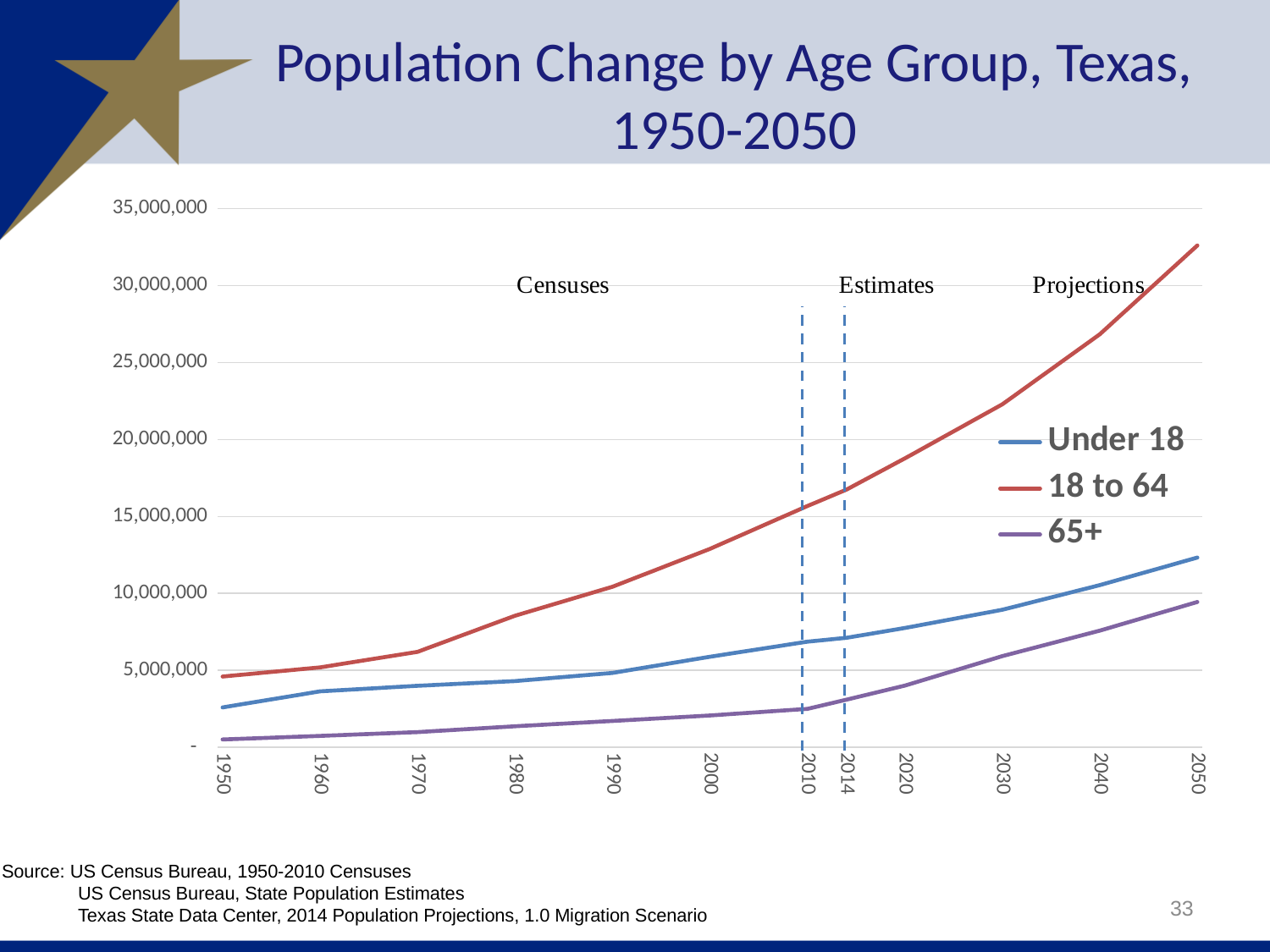
Which age group has the highest population in 2050? 18 to 64 Which age group has the lowest population in 1950? 65+ How many year labels are shown along the x axis? 12 Is the value for 65+ in 2050 greater or less than 10,000,000? less Is the value for Under 18 in 1950 greater or less than 5,000,000? less How many series does the legend list? 3 What kind of chart is shown on the slide? Line chart Does the 18 to 64 population rise or fall from 1950 to 2050? Rises Is the value for 18 to 64 in 2030 greater or less than 20,000,000? greater What is the title of the chart? Population Change by Age Group, Texas, 1950-2050 In 2050, which is larger: the Under 18 population or the 65+ population? Under 18